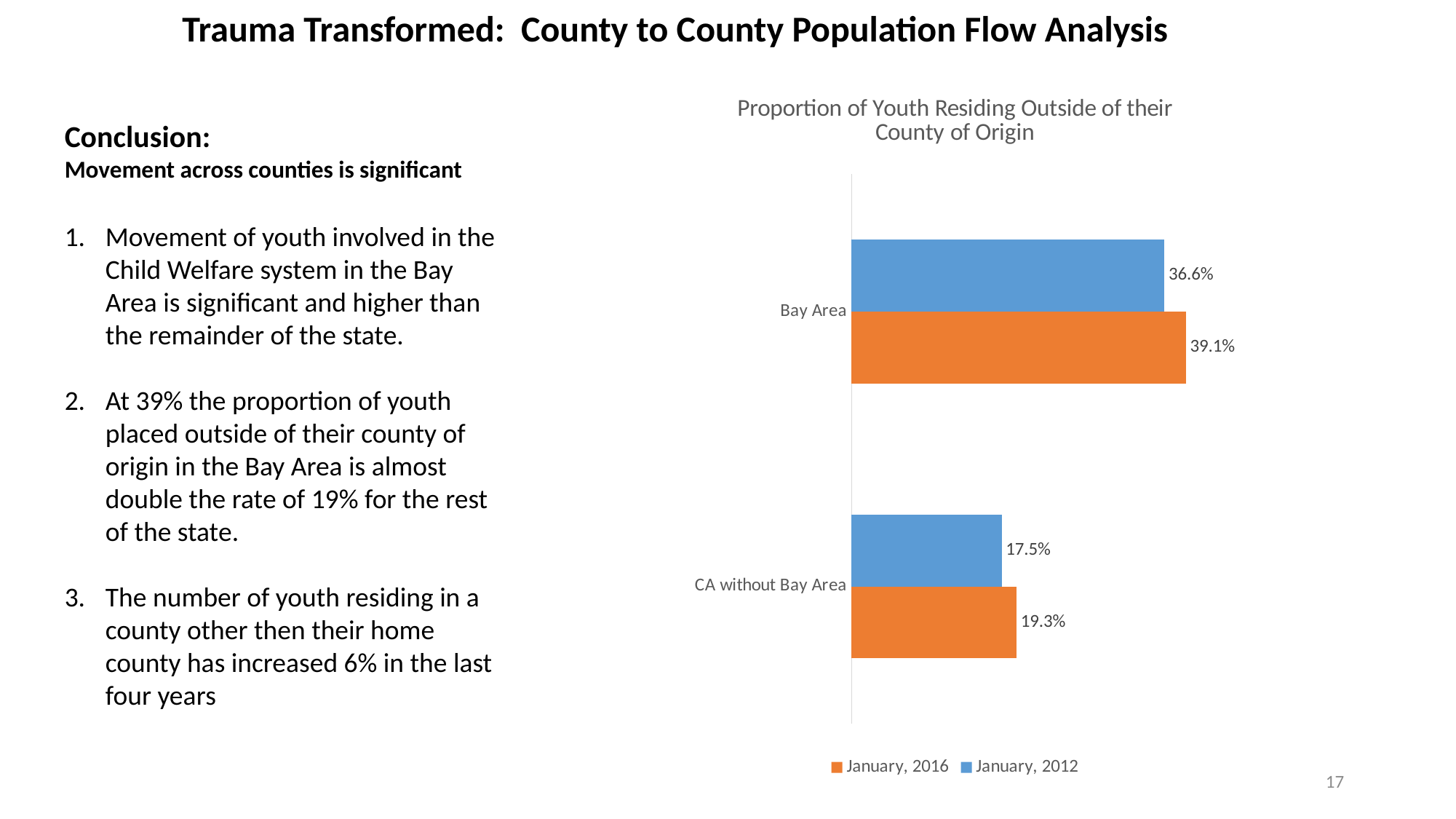
What is the difference between the January, 2016 values for Bay Area and CA without Bay Area? 19.8% What is the value for Bay Area in January, 2016? 39.1% What is the value for CA without Bay Area in January, 2012? 17.5% How many categories are shown on the chart? 2 What kind of chart is shown on the slide? Bar chart Which is larger for CA without Bay Area: January, 2016 or January, 2012? January, 2016 Which category has the lowest value in January, 2012? CA without Bay Area How many series does the legend list? 2 What is the value for Bay Area in January, 2012? 36.6% What is the difference between the Bay Area values for January, 2016 and January, 2012? 2.5% Which category has the highest value in January, 2016? Bay Area What is the value for CA without Bay Area in January, 2016? 19.3%